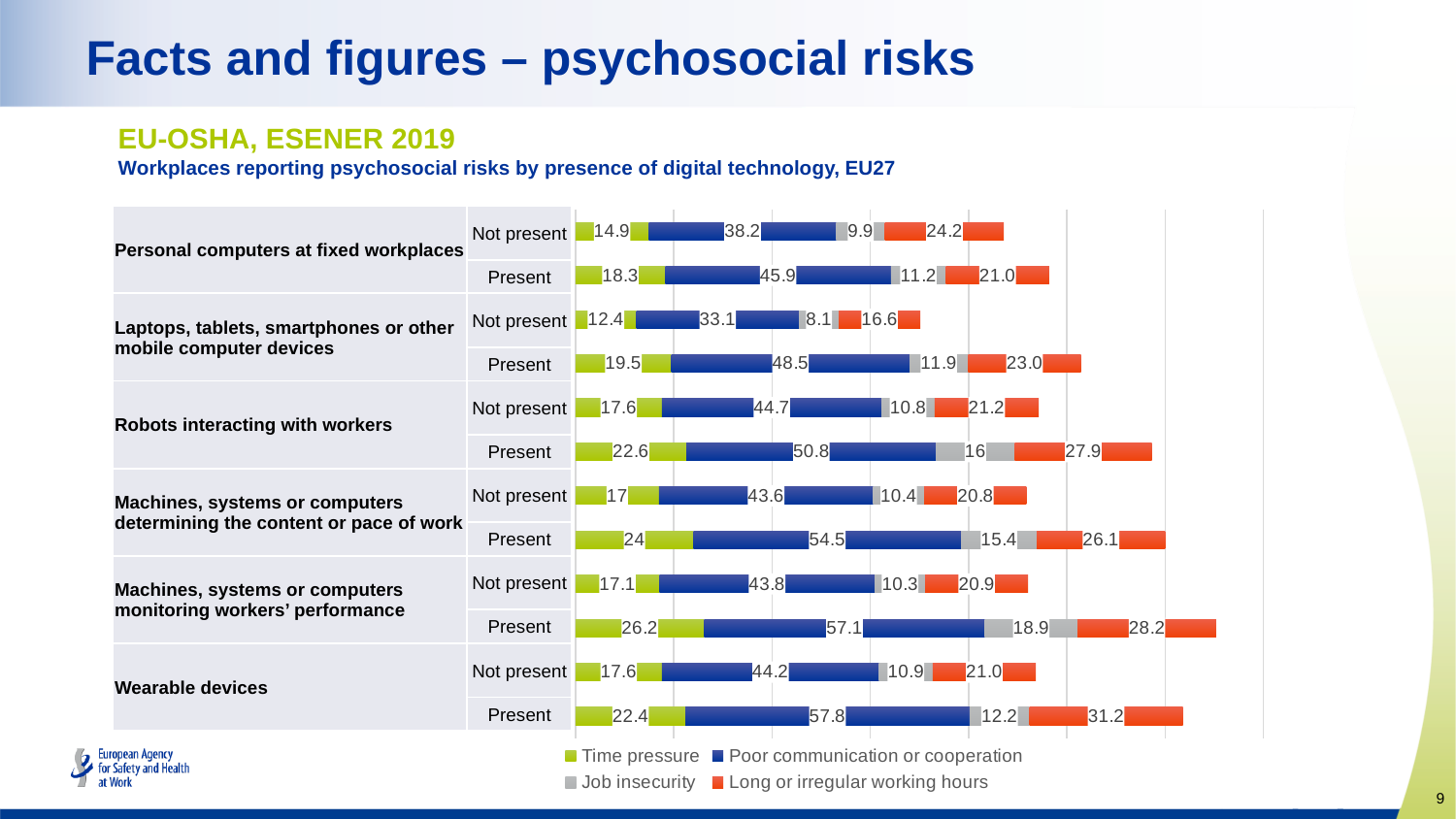
How many bars are plotted in the chart? 12 For 'Wearable devices', is the Long or irregular working hours value larger for Present or Not present? Present What is the Time pressure value for 'Personal computers at fixed workplaces', Not present? 14.9 What is the difference in Poor communication or cooperation between Present and Not present for 'Personal computers at fixed workplaces'? 7.7 What is the Poor communication or cooperation value for 'Wearable devices', Present? 57.8 How many series does the legend list? 4 What is the Long or irregular working hours value for 'Laptops, tablets, smartphones or other mobile computer devices', Not present? 16.6 What is the Job insecurity value for 'Robots interacting with workers', Present? 16 Which bar has the lowest Poor communication or cooperation value? Laptops, tablets, smartphones or other mobile computer devices, Not present (33.1) What is the total of the stacked bar for 'Wearable devices', Present? 123.6 Which bar has the highest Time pressure value? Machines, systems or computers monitoring workers' performance, Present (26.2) What kind of chart is shown on the slide? Stacked horizontal bar chart